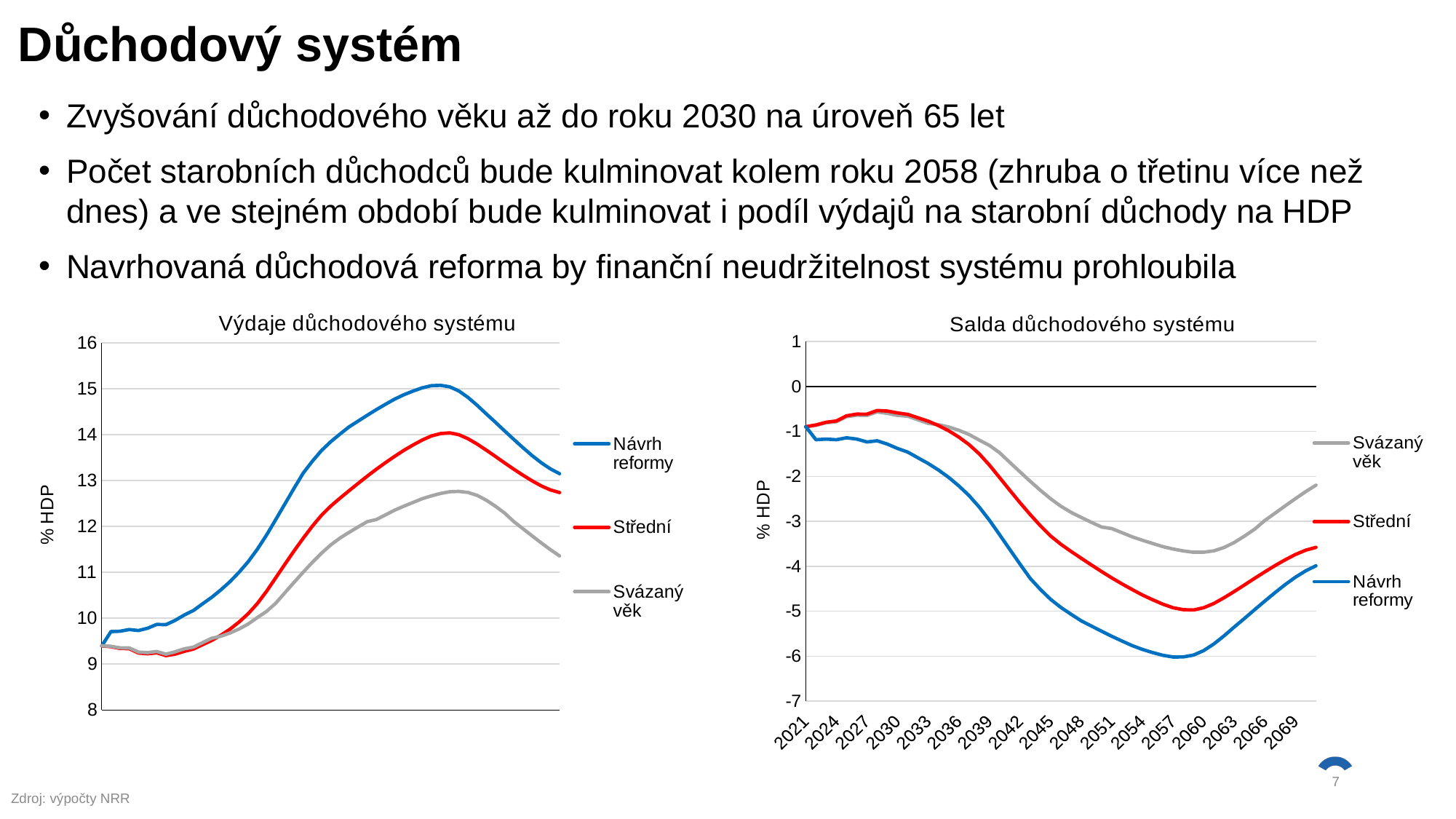
What unit is shown on the y-axis of the "Výdaje důchodového systému" chart? % HDP How many series does the legend of the "Salda důchodového systému" chart list? 3 In the "Výdaje důchodového systému" chart, is the peak value of the Svázaný věk series greater or less than 13? less In the "Salda důchodového systému" chart, which series has the higher value in 2069, Svázaný věk or Návrh reformy? Svázaný věk In the "Salda důchodového systému" chart, do the values of the Návrh reformy series rise or fall between 2033 and 2057? fall In the "Salda důchodového systému" chart, is the lowest value of the Střední series greater or less than -4? less In the "Salda důchodového systému" chart, which series reaches the lowest (most negative) value? Návrh reformy In the "Výdaje důchodového systému" chart, which series has the lowest peak value? Svázaný věk In the "Salda důchodového systému" chart, is the lowest value of the Svázaný věk series greater or less than -4? greater What type of chart is the "Výdaje důchodového systému" chart? line chart In the "Výdaje důchodového systému" chart, which series reaches the highest peak value? Návrh reformy